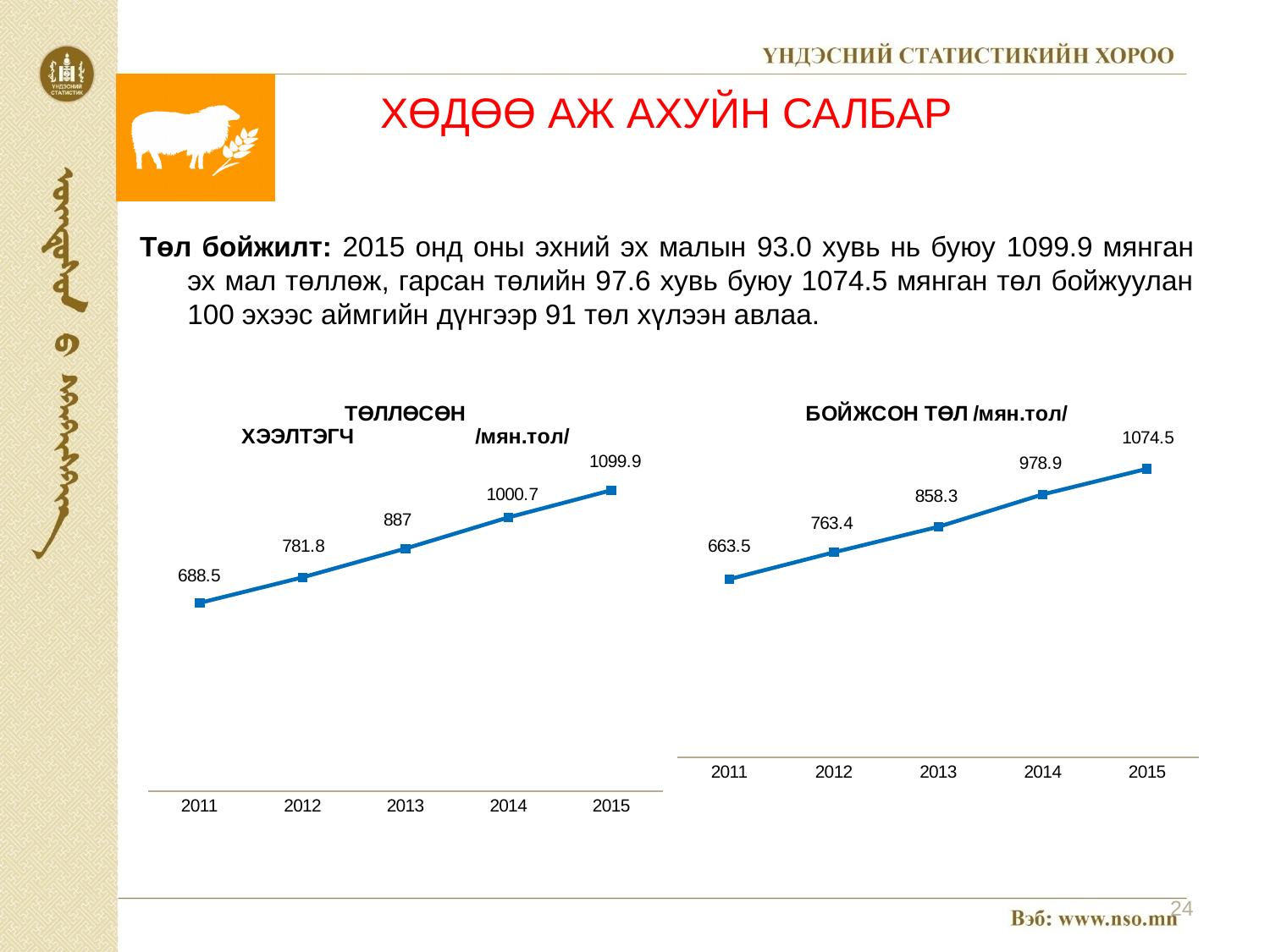
In the right chart (БОЙЖСОН ТӨЛ), do the values rise or fall from 2011 to 2015? Rise In the right chart (БОЙЖСОН ТӨЛ), which year has the lowest value? 2011 What type of chart is the left chart (ТӨЛЛӨСӨН ХЭЭЛТЭГЧ)? Line chart In the right chart (БОЙЖСОН ТӨЛ), what is the difference between the 2013 and 2012 values? 94.9 In the left chart (ТӨЛЛӨСӨН ХЭЭЛТЭГЧ), what is the value for 2012? 781.8 In the left chart (ТӨЛЛӨСӨН ХЭЭЛТЭГЧ), which year has the highest value? 2015 Which is larger: the 2014 value in the left chart (ТӨЛЛӨСӨН ХЭЭЛТЭГЧ) or the 2014 value in the right chart (БОЙЖСОН ТӨЛ)? Left chart (1000.7) How many years are plotted in the right chart (БОЙЖСОН ТӨЛ)? 5 In the left chart (ТӨЛЛӨСӨН ХЭЭЛТЭГЧ), what is the difference between the 2015 and 2011 values? 411.4 In the right chart (БОЙЖСОН ТӨЛ), what is the value for 2014? 978.9 In the left chart (ТӨЛЛӨСӨН ХЭЭЛТЭГЧ), what is the value for 2013? 887 What unit is shown in the title of the right chart (БОЙЖСОН ТӨЛ)? мян.тол